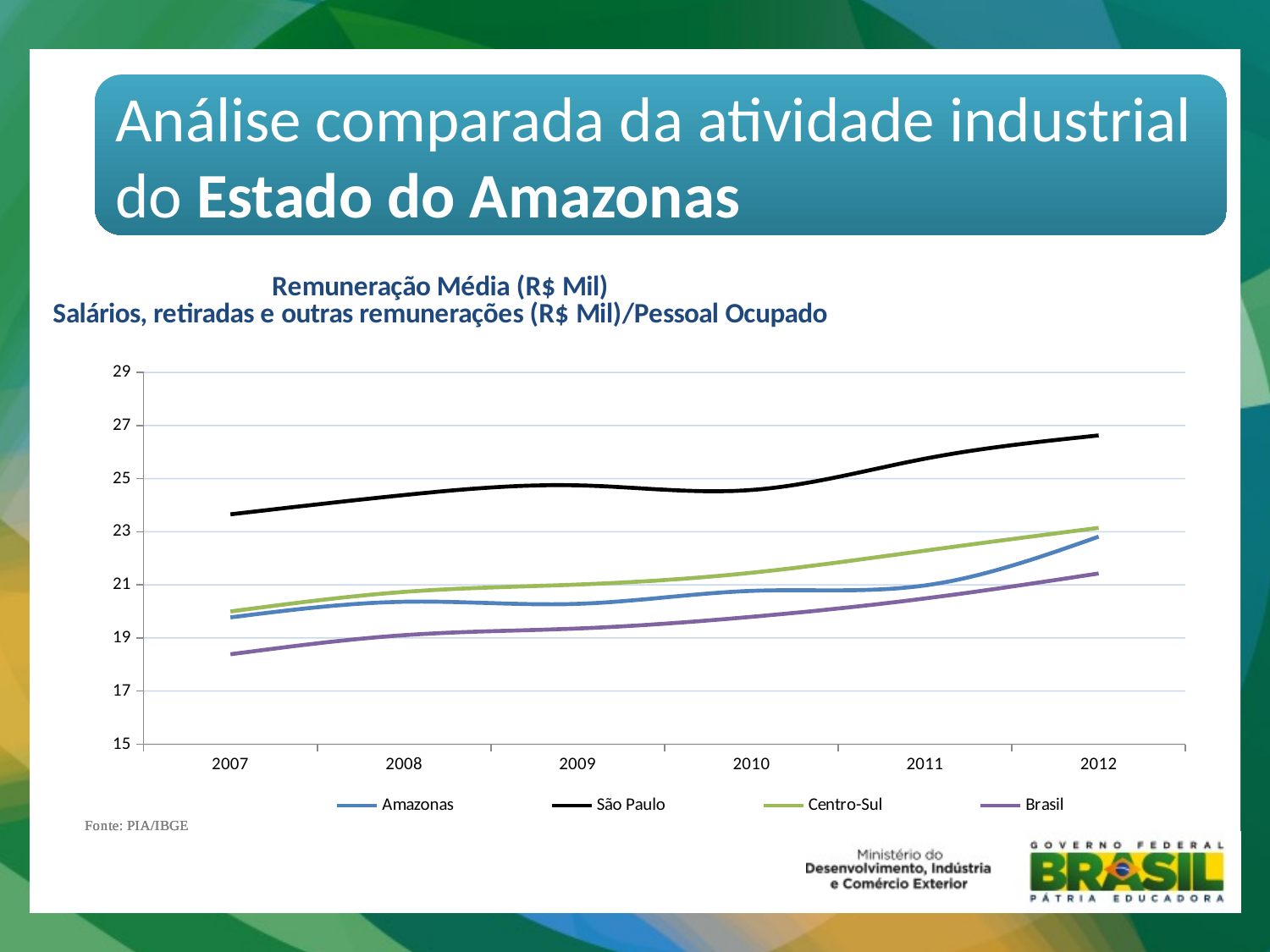
Which series has the highest values across all years? São Paulo In 2011, which is larger: the value for Centro-Sul or the value for Amazonas? Centro-Sul How many series does the legend list? 4 Is the value for Amazonas in 2007 greater or less than 21? less Is the value for Brasil in 2007 greater or less than 19? less What colour is the São Paulo line in the legend? black Does the Brasil series rise or fall from 2007 to 2012? rise How many years are plotted along the x axis? 6 What kind of chart is shown on the slide? line chart Is the value for São Paulo in 2012 greater or less than 27? less Which series has the lowest values across all years? Brasil